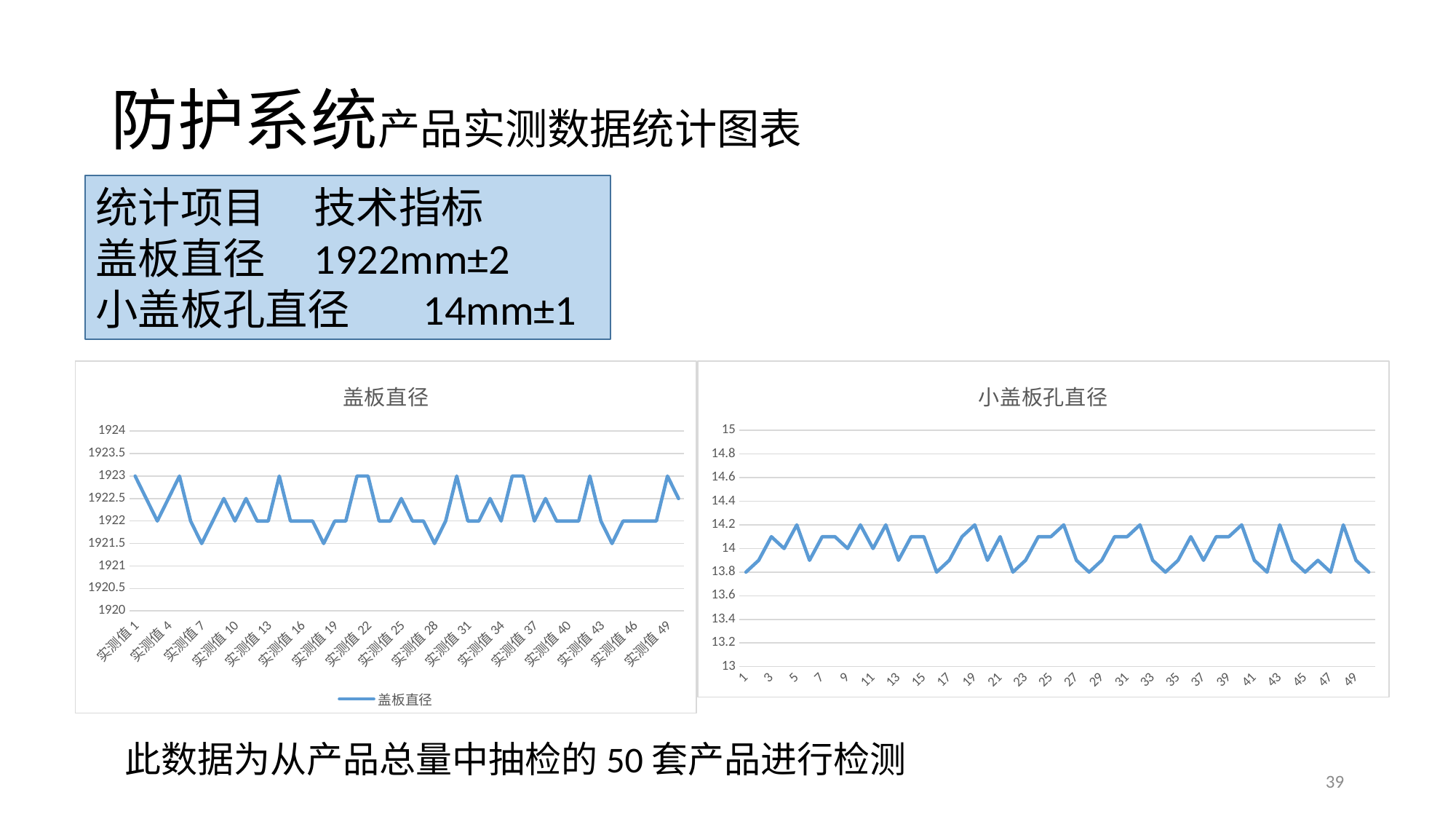
On the 小盖板孔直径 chart, is the value at point 1 greater or less than 14? less On the 盖板直径 chart, what is the value for 实测值 1? 1923 On the 盖板直径 chart, is the value for 实测值 1 greater or less than 1922? greater What is the legend entry shown under the chart on the left? 盖板直径 On the 盖板直径 chart, what is the highest value the line reaches? 1923 On the 小盖板孔直径 chart, what is the value at point 1? 13.8 What kind of chart is the 盖板直径 chart on the left? line chart What kind of chart is the 小盖板孔直径 chart on the right? line chart What is the title of the chart on the right? 小盖板孔直径 How many series does the legend of the 盖板直径 chart list? 1 On the 盖板直径 chart, what is the lowest value the line reaches? 1921.5 On the 小盖板孔直径 chart, what is the highest value the line reaches? 14.2